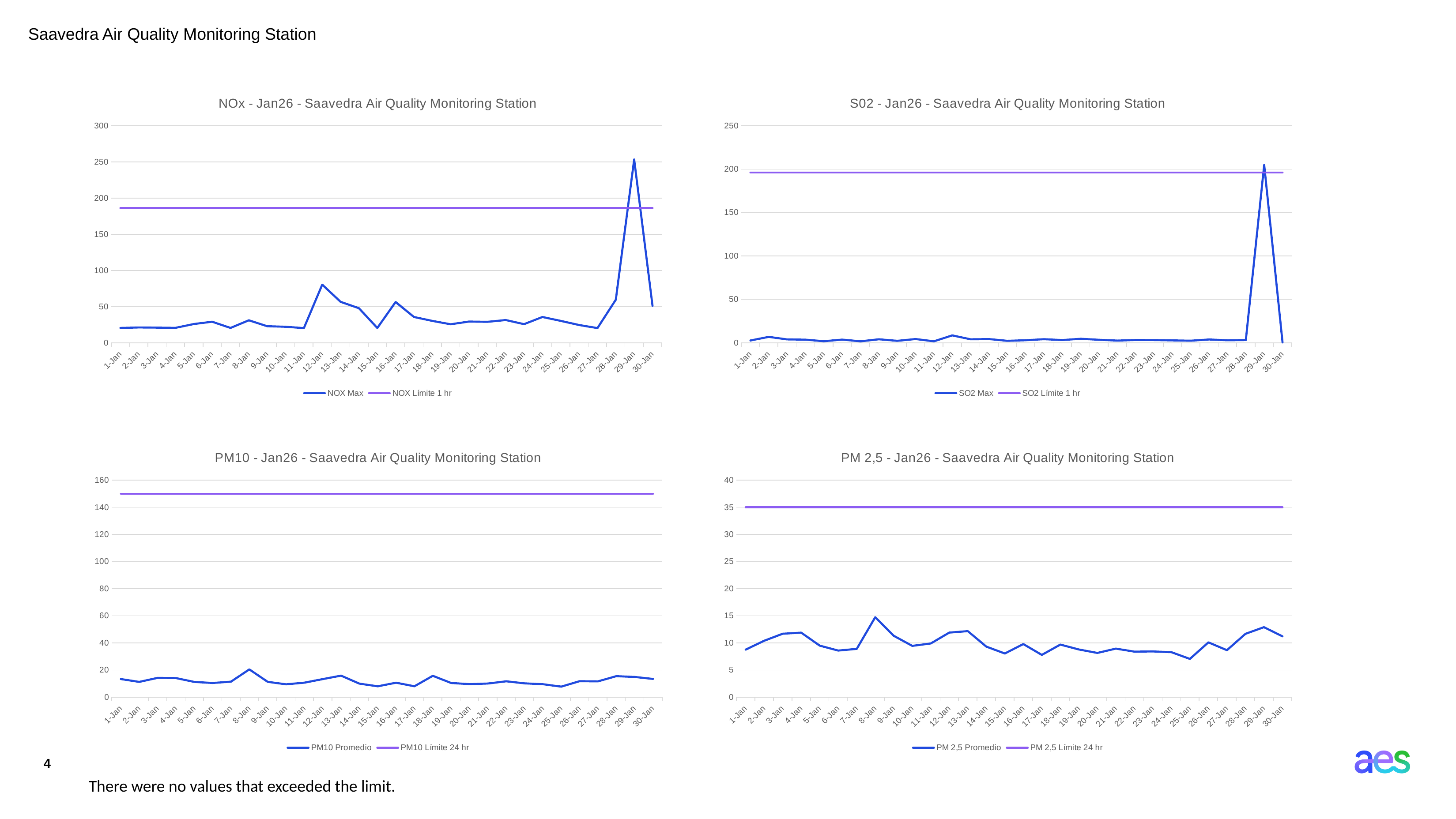
How many dates are plotted along the x axis of the PM10 - Jan26 chart? 30 What kind of chart is the NOx - Jan26 chart? line chart In the S02 - Jan26 chart, is the SO2 Max value on 29-Jan greater or less than 150? greater In the NOx - Jan26 chart, on which date does NOX Max reach its highest value? 29-Jan How many series does the legend of the S02 - Jan26 chart list? 2 In the PM 2,5 - Jan26 chart, on which date does PM 2,5 Promedio reach its highest value? 8-Jan In the PM10 - Jan26 chart, on which date does PM10 Promedio reach its highest value? 8-Jan In the PM10 - Jan26 chart, is the PM10 Límite 24 hr line greater or less than 100? greater In the NOx - Jan26 chart, is the NOX Max value on 29-Jan greater or less than 200? greater What are the two legend entries of the PM 2,5 - Jan26 chart? PM 2,5 Promedio and PM 2,5 Límite 24 hr